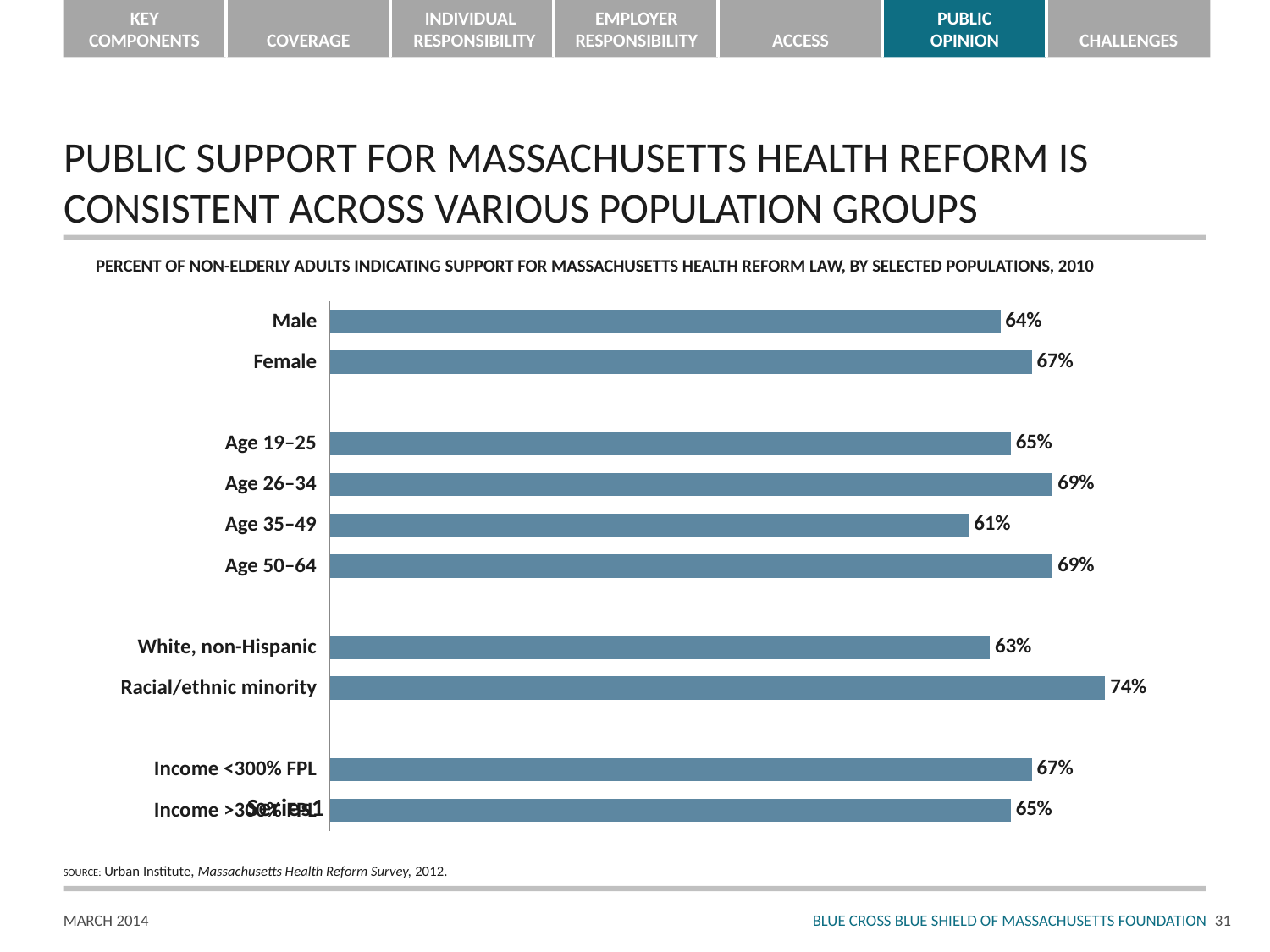
What percent of male non-elderly adults indicated support for the Massachusetts health reform law? 64% How many population groups are plotted in the chart? 10 What is the difference between the Female and Male values? 3 percentage points What is the difference in percentage points between Racial/ethnic minority and White, non-Hispanic? 11 percentage points What is the value shown for Income <300% FPL? 67% What is the value shown for Racial/ethnic minority? 74% What percent of adults aged 26–34 indicated support? 69% Which is larger, the value for Age 19–25 or the value for Age 35–49? Age 19–25 Which population group has the highest percentage indicating support? Racial/ethnic minority Which population group has the lowest percentage indicating support? Age 35–49 What is the value shown for Female? 67% What kind of chart is shown on the slide? Bar chart